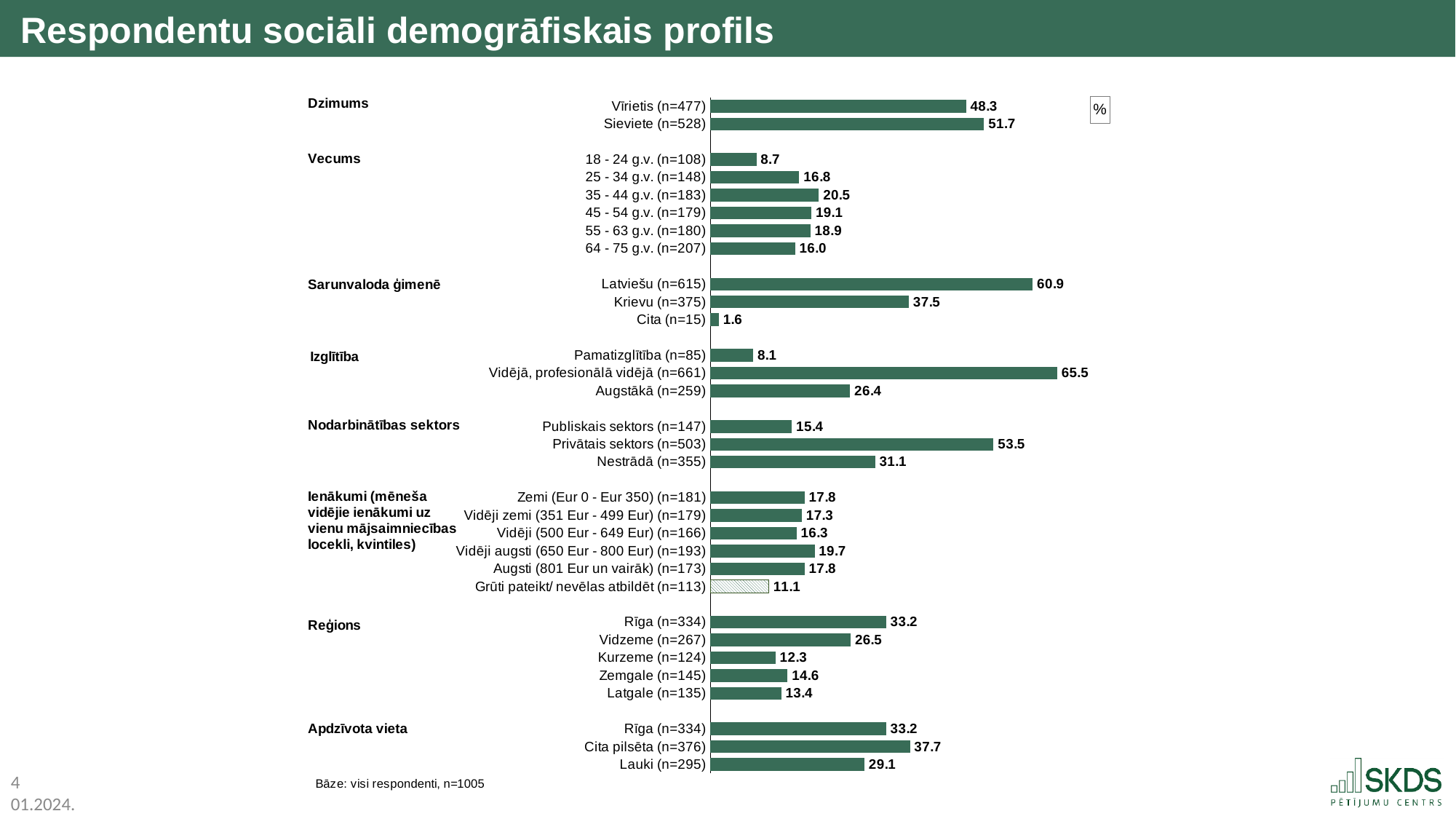
Which region in the Reģions section has the lowest value? Kurzeme (n=124) Which category has the highest value on the whole chart? Vidējā, profesionālā vidējā (n=661) How many age groups are shown in the Vecums section? 6 Which is larger, the value for Publiskais sektors (n=147) or Nestrādā (n=355)? Nestrādā (n=355) What is the difference between the values for Latviešu (n=615) and Krievu (n=375)? 23.4 What is the value for Latviešu (n=615) in the Sarunvaloda ģimenē group? 60.9 Which age group in the Vecums section has the highest value? 35 - 44 g.v. (n=183) What kind of chart is shown on the slide? Bar chart Which bar is drawn with a hatched pattern instead of solid fill? Grūti pateikt/ nevēlas atbildēt (n=113) What is the value for Sieviete (n=528) in the Dzimums group? 51.7 What is the difference between the values for Sieviete (n=528) and Vīrietis (n=477)? 3.4 What is the value for Cita (n=15) in the Sarunvaloda ģimenē group? 1.6